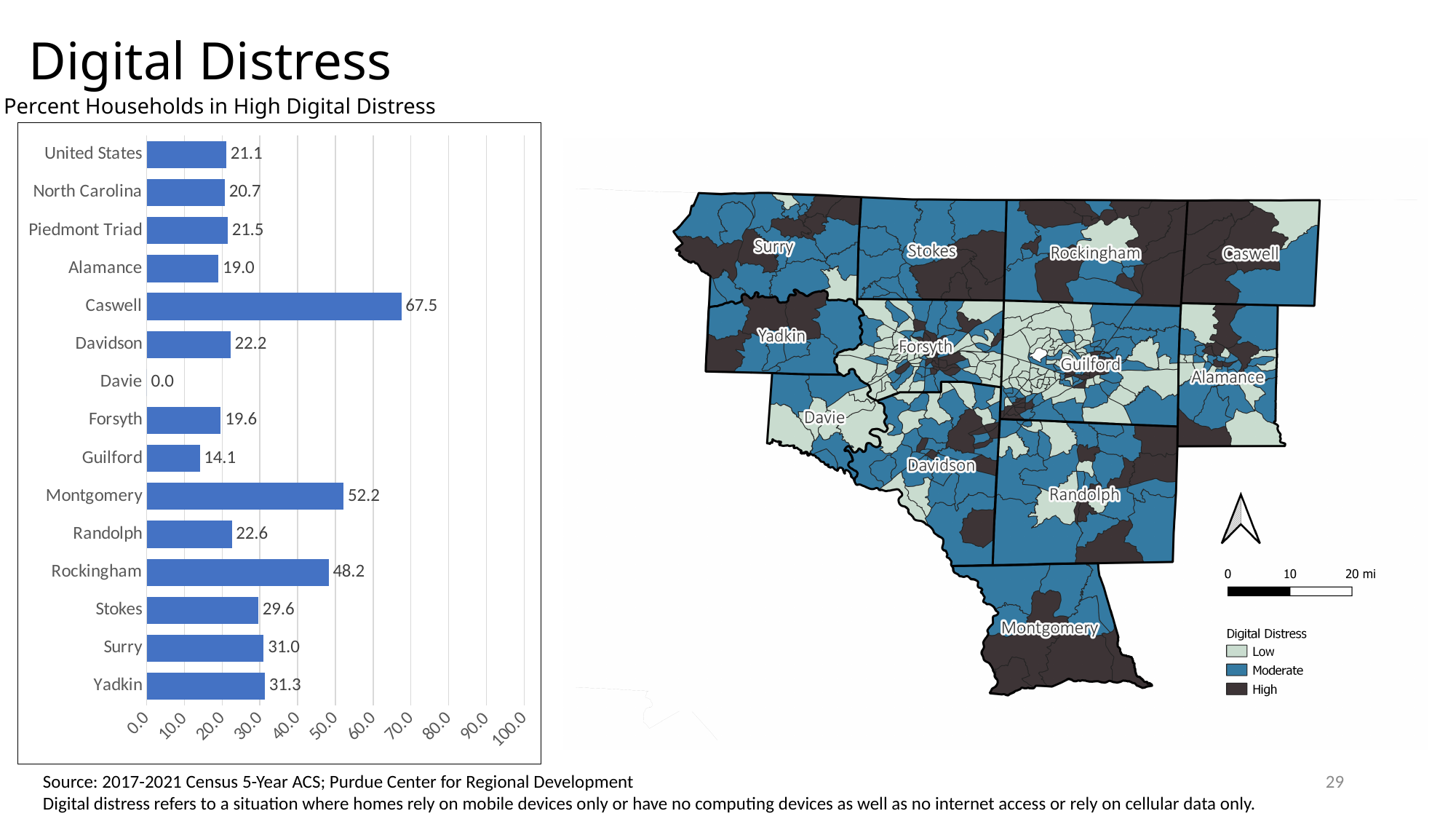
Which category has the lowest value in the bar chart? Davie Which category has the highest value in the bar chart? Caswell What is the difference between the values for Yadkin and Surry in the bar chart? 0.3 What is the value for Caswell in the bar chart? 67.5 What is the difference between the values for Montgomery and Rockingham in the bar chart? 4.0 Is the value for Montgomery in the bar chart greater or less than 50.0? greater How many categories are shown in the bar chart? 15 What is the value for North Carolina in the bar chart? 20.7 What kind of chart is shown on the left of the slide? bar chart Which is larger in the bar chart, the value for Stokes or the value for Surry? Surry What is the value for Guilford in the bar chart? 14.1 What is the title of the bar chart? Percent Households in High Digital Distress